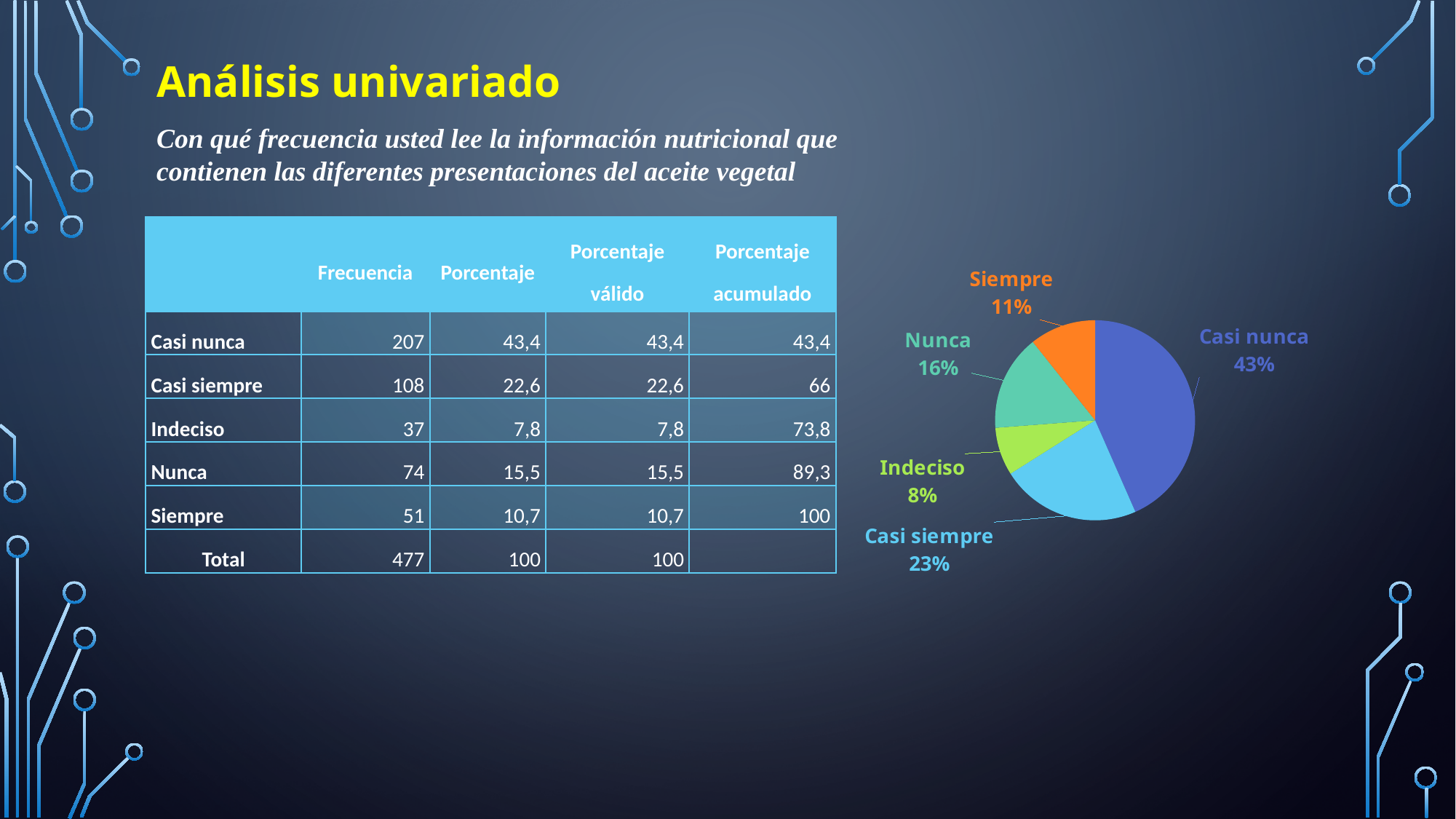
What colour is the Siempre slice in the pie chart? orange What is the difference in percentage points between the Casi nunca and Casi siempre slices in the pie chart? 20 What share of the pie chart does Indeciso represent? 8% What kind of chart is shown on the slide? pie chart What share of the pie chart does Siempre represent? 11% Which category has the smallest slice in the pie chart? Indeciso What share of the pie chart does Casi siempre represent? 23% Which category has the largest slice in the pie chart? Casi nunca How many slices does the pie chart have? 5 Which slice is larger in the pie chart, Nunca or Siempre? Nunca